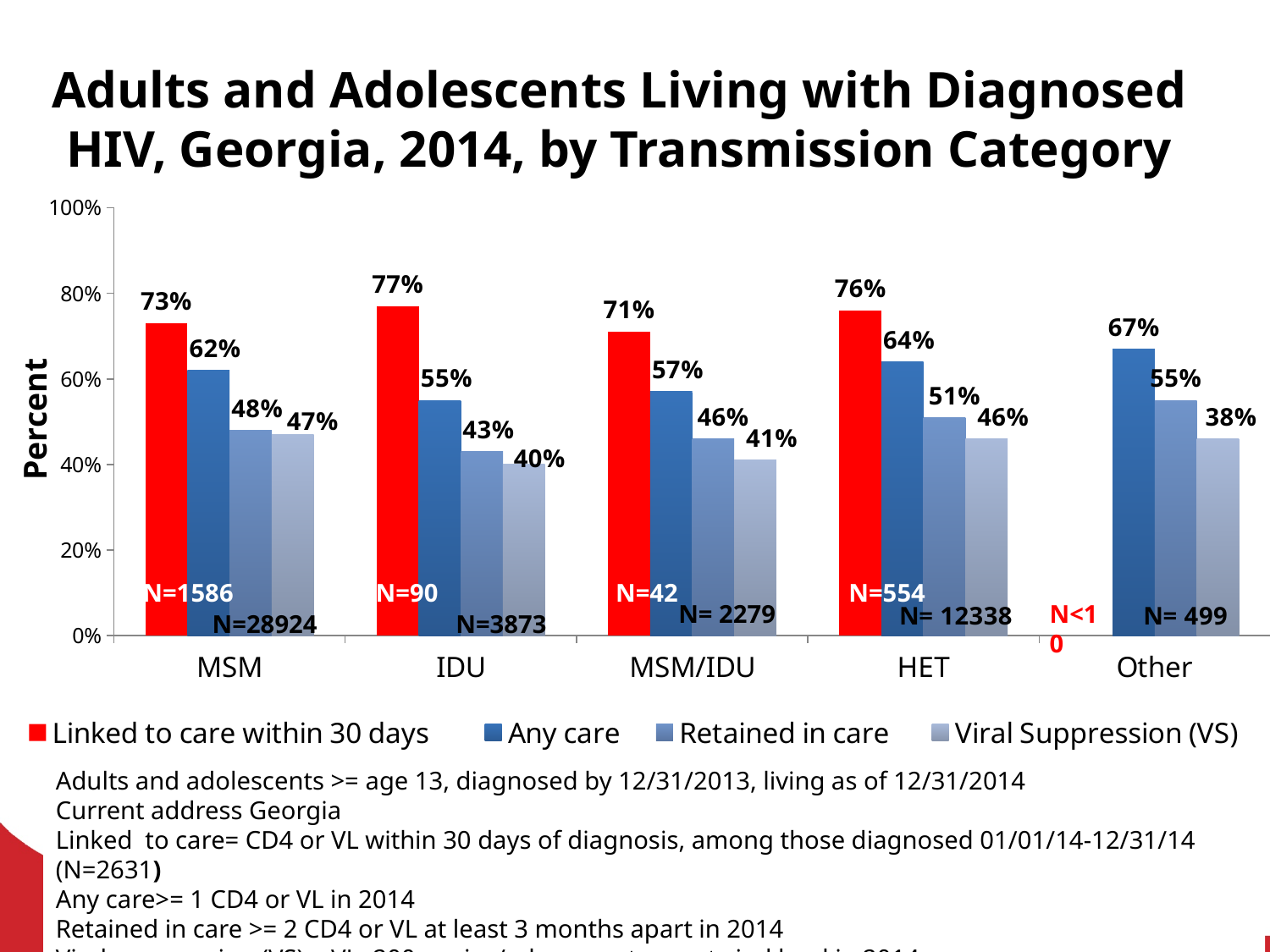
What kind of chart is shown on the slide? Bar chart How many series does the legend list? 4 What is the Viral Suppression (VS) value for Other? 38% What is the Any care value for HET? 64% How many transmission categories are shown on the x axis? 5 Which transmission category has the lowest Viral Suppression (VS) value? Other What is the Retained in care value for MSM/IDU? 46% What is the difference between the Any care value and the Viral Suppression (VS) value for MSM? 15% Which series is shown in red in the legend? Linked to care within 30 days Which is larger, the Retained in care value for HET or for IDU? HET Which transmission category has the highest Linked to care within 30 days value? IDU What is the value for Linked to care within 30 days for IDU? 77%